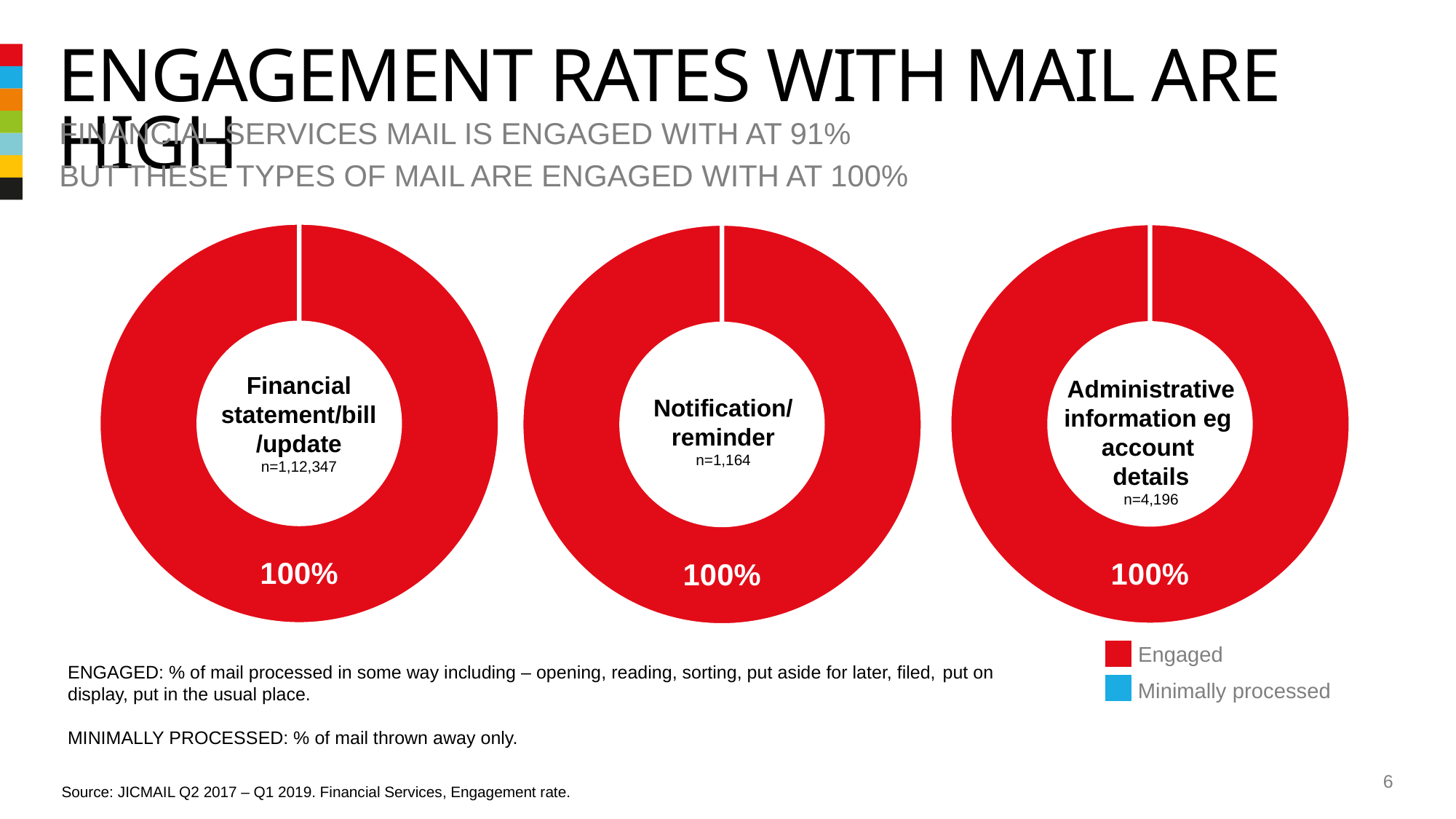
What is the sample size (n) shown in the Administrative information eg account details chart? n=4,196 How many series does the legend list for the charts? 2 What kind of chart is used to show the engagement rate for Financial statement/bill/update mail? Doughnut chart What are the two series named in the legend? Engaged and Minimally processed In the Administrative information eg account details chart, what percentage of mail is Engaged? 100% How many doughnut charts are shown on the slide? 3 What is the sample size (n) shown in the Notification/reminder chart? n=1,164 In the Notification/reminder chart, what percentage of mail is Engaged? 100% What colour represents Engaged in the charts? Red In the Financial statement/bill/update chart, what percentage of mail is Engaged? 100% In the Notification/reminder chart, what share of the doughnut does the Engaged slice take up? 100% Is the Engaged value in the Administrative information eg account details chart greater or less than 91%? greater